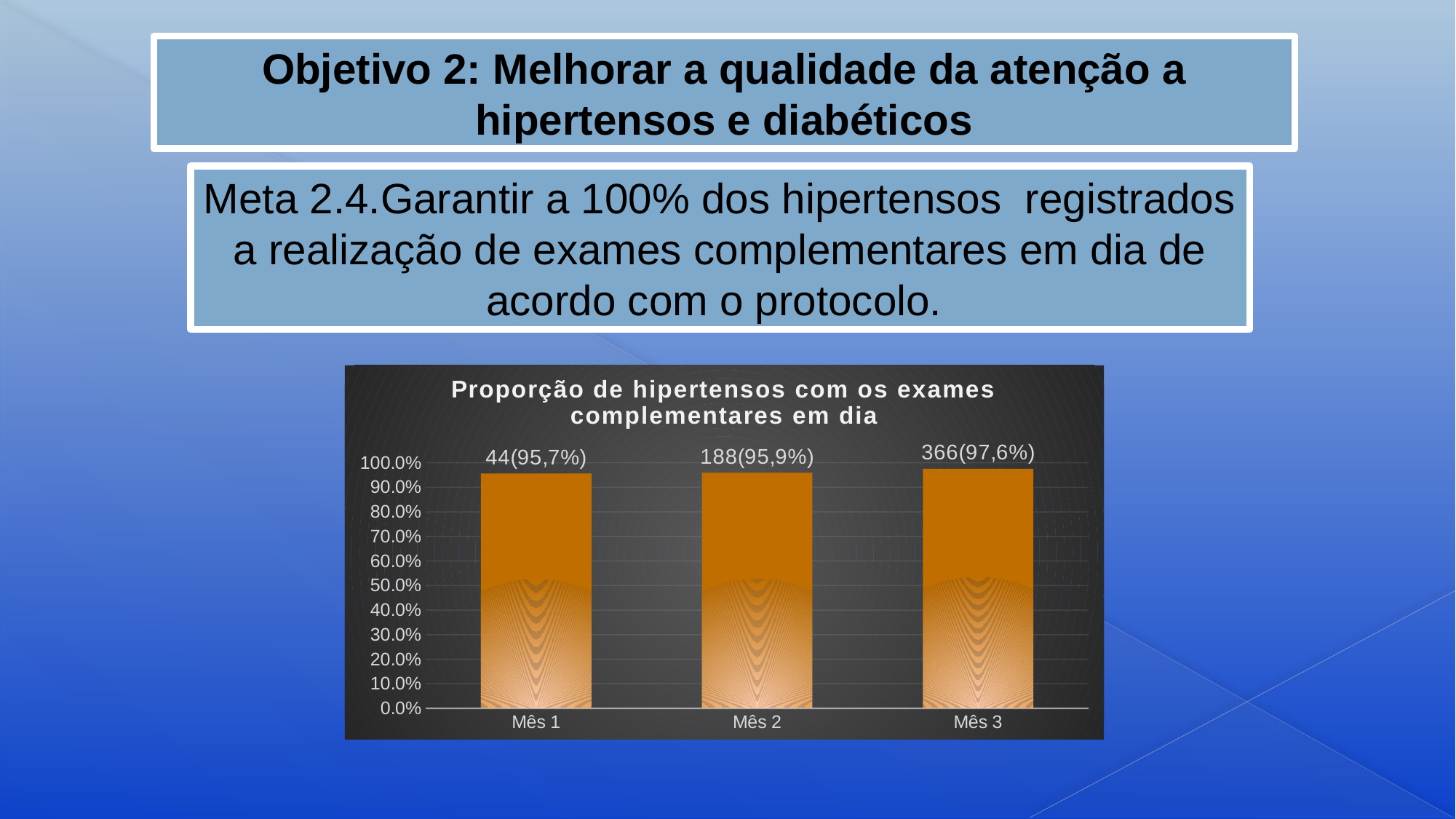
What is the title of the chart? Proporção de hipertensos com os exames complementares em dia What is the data label shown for Mês 2 in the chart? 188(95,9%) Is the value for Mês 1 greater or less than 90.0%? greater How many months (categories) are shown on the x axis of the chart? 3 What is the difference in percentage points between the proportion for Mês 3 and Mês 1? 1,9 percentage points What is the data label shown for Mês 3 in the chart? 366(97,6%) Do the proportions rise or fall from Mês 1 to Mês 3? rise Is the proportion for Mês 3 larger or smaller than the proportion for Mês 1? larger Which month has the highest proportion of hypertensive patients with complementary exams up to date? Mês 3 What kind of chart is shown on the slide? bar chart Which month has the lowest proportion according to the data labels? Mês 1 What is the data label shown for Mês 1 in the chart? 44(95,7%)